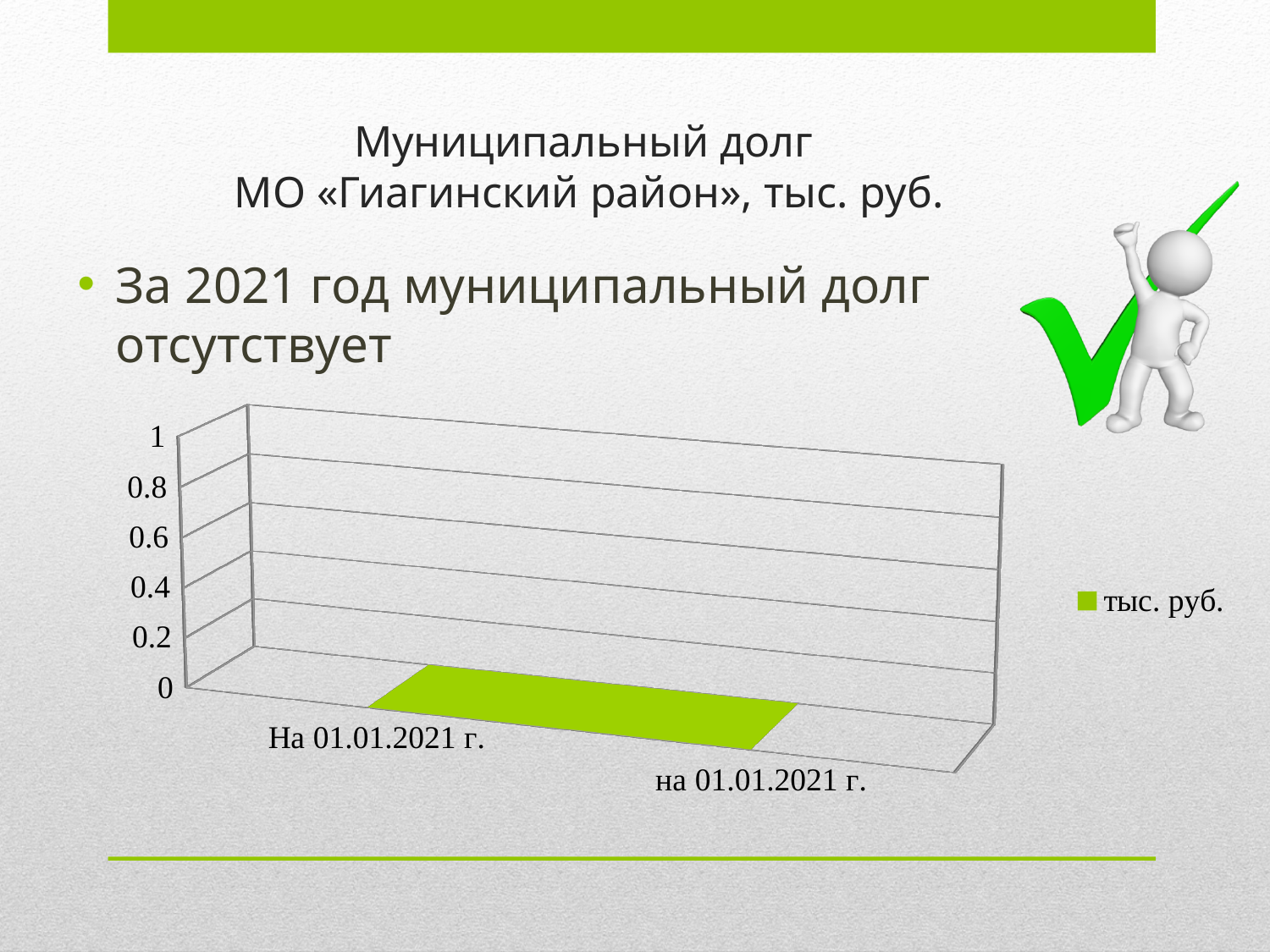
What value does the bar for the first category (На 01.01.2021 г.) land on? 0 What is the highest value shown on the vertical axis of the chart? 1 Is the value for the first category (На 01.01.2021 г.) greater or less than 0.2? less What is the legend entry of the chart? тыс. руб. How many series does the chart legend list? 1 Is the value for the second category (на 01.01.2021 г.) greater or less than 0.4? less What kind of chart is shown on the slide? line chart How many categories are shown along the x axis of the chart? 2